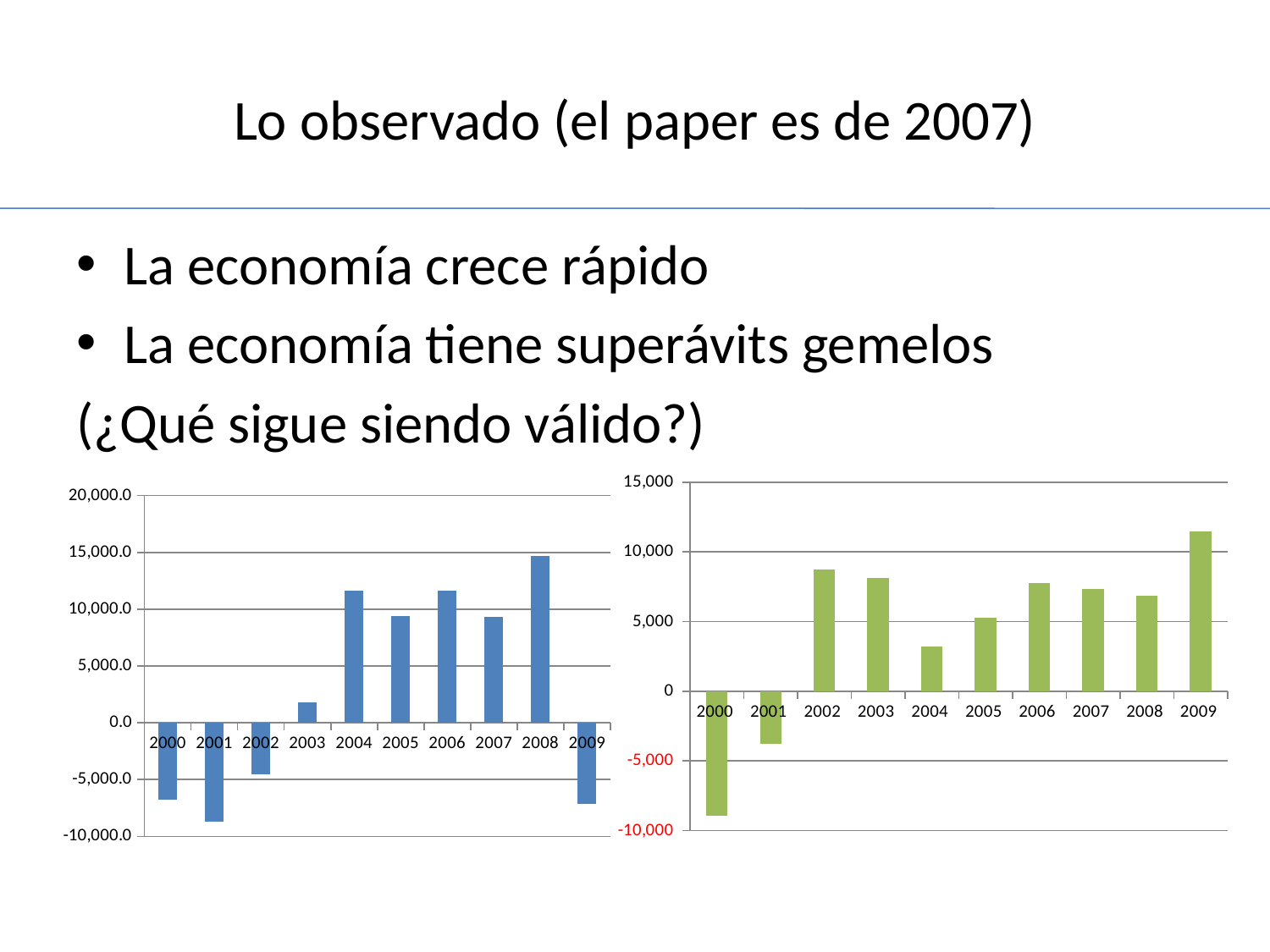
In the right chart, which year has the highest value? 2009 In the right chart, is the value for 2009 greater or less than 10,000? greater What kind of chart is the left chart on the slide? bar chart In the left chart, which year has the lowest value? 2001 How many years are shown on the x axis of the right chart? 10 In the right chart, which year has the lowest value? 2000 In the left chart, is the value for 2004 greater or less than 10,000.0? greater In the right chart, is the value for 2004 greater or less than 5,000? less What colour are the bars in the right chart? green In the left chart, which year has the highest value? 2008 In the right chart, which year has the larger value, 2001 or 2002? 2002 In the left chart, which year has the larger value, 2003 or 2005? 2005